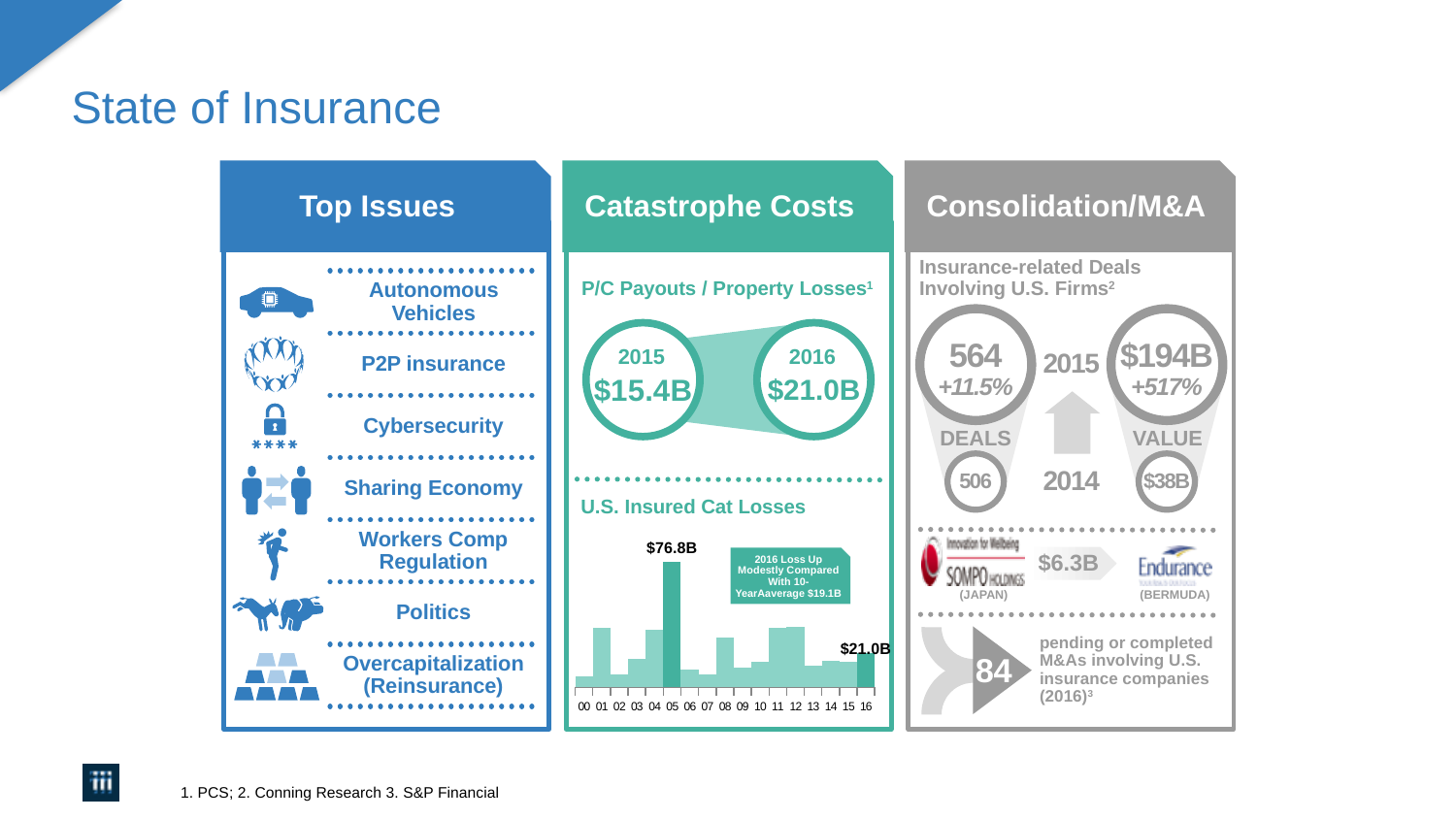
According to the annotation on the "U.S. Insured Cat Losses" chart, what is the 10-year average loss? $19.1B In the "U.S. Insured Cat Losses" chart, which year has the larger value, 2005 or 2016? 2005 In the "U.S. Insured Cat Losses" chart, which year has the larger value, 2004 or 2016? 2004 In the "U.S. Insured Cat Losses" chart, what is the difference between the 2005 value and the 2016 value? $55.8B What kind of chart is the "U.S. Insured Cat Losses" chart? bar chart In the "U.S. Insured Cat Losses" chart, which year has the larger value, 2001 or 2016? 2001 In the "U.S. Insured Cat Losses" chart, what is the value labeled for 2016? $21.0B In the "U.S. Insured Cat Losses" chart, which year has the highest insured cat losses? 2005 How many years (bars) are shown on the x axis of the "U.S. Insured Cat Losses" chart? 17 In the "U.S. Insured Cat Losses" chart, what is the value labeled for 2005? $76.8B What is the first year shown on the x axis of the "U.S. Insured Cat Losses" chart? 00